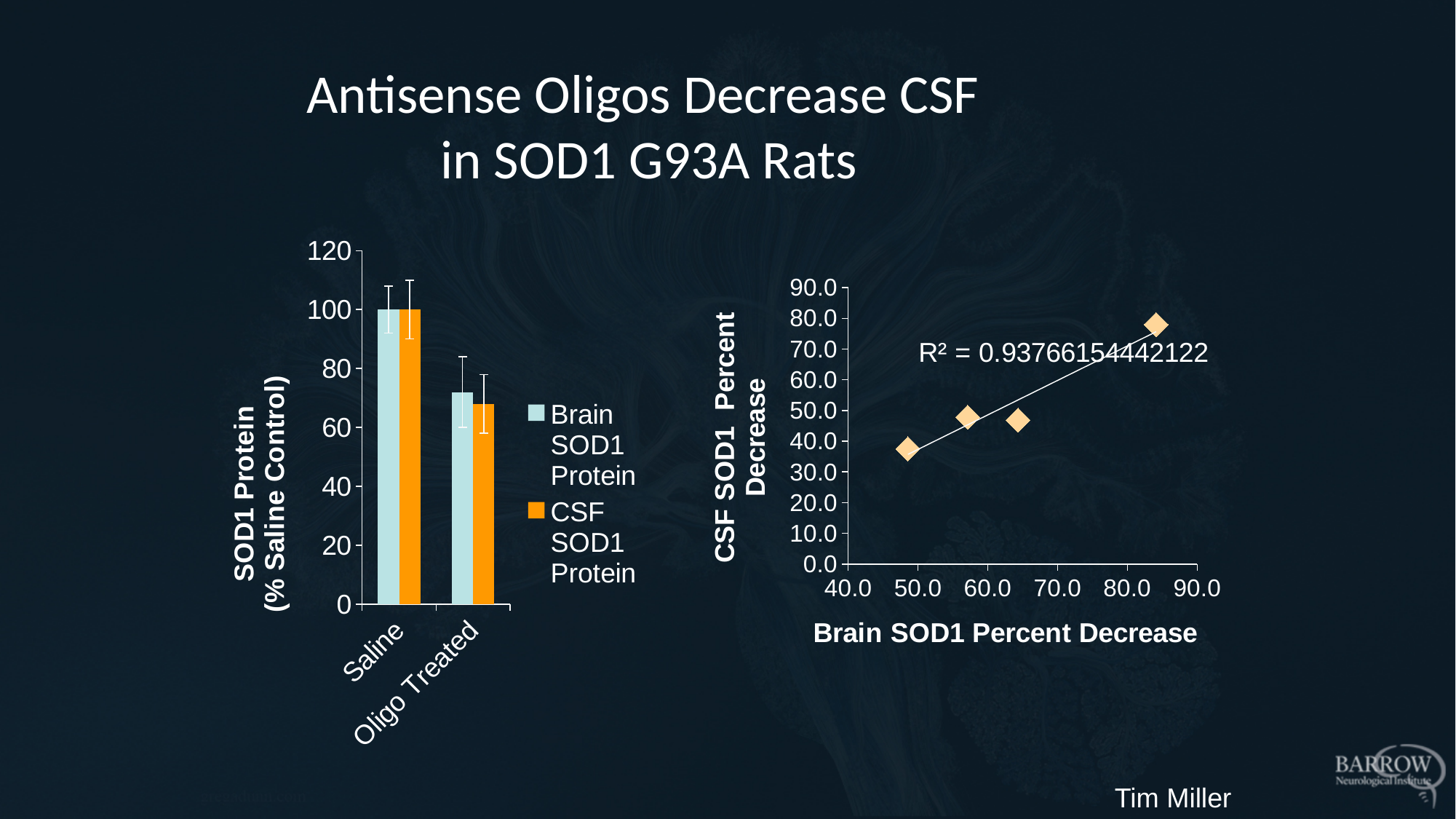
In the left bar chart, how many categories are shown on the x axis? 2 In the left bar chart, is the CSF SOD1 Protein value for Oligo Treated greater or less than 60? greater In the right scatter chart, what R² value is printed? R² = 0.93766154442122 What kind of chart is the right chart on the slide? scatter chart In the left bar chart, which category has the lower Brain SOD1 Protein value, Saline or Oligo Treated? Oligo Treated In the right scatter chart, do the CSF SOD1 Percent Decrease values generally rise or fall as Brain SOD1 Percent Decrease increases? rise In the left bar chart, is the Brain SOD1 Protein value for Oligo Treated greater or less than 80? less In the left bar chart, how many series does the legend list? 2 In the left bar chart, what is the value of CSF SOD1 Protein for Saline? 100 In the left bar chart, what is the value of Brain SOD1 Protein for Saline? 100 In the right scatter chart, how many data points are plotted? 4 What kind of chart is the left chart on the slide? bar chart